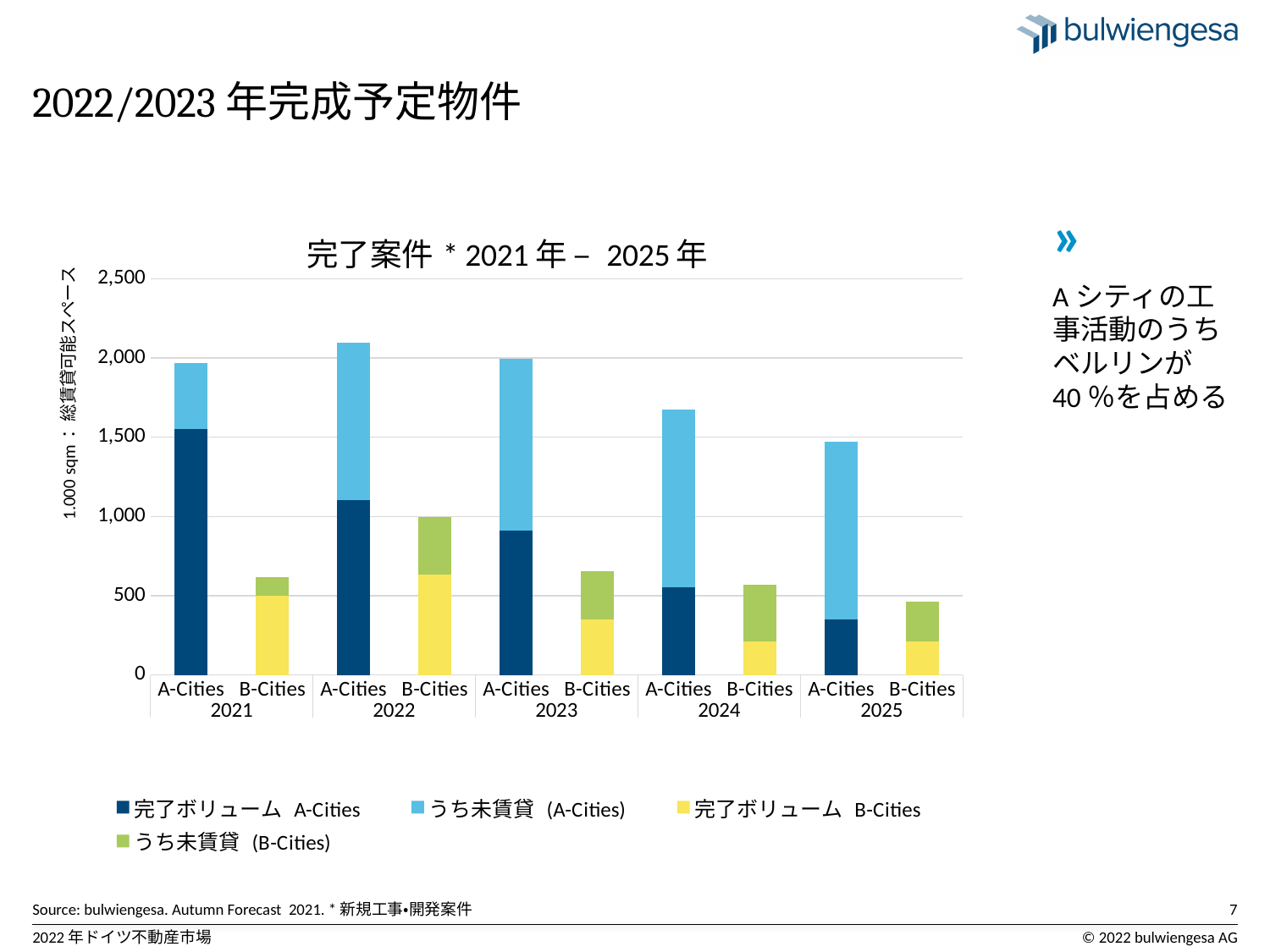
What is the title of the chart? 完了案件 * 2021 年 – 2025 年 Do the total values for A-Cities rise or fall from 2022 to 2025? fall Is the total value for B-Cities in 2025 greater or less than 500? less Which has the larger total value: A-Cities in 2023 or A-Cities in 2024? A-Cities in 2023 Which bar has the lowest total value? B-Cities 2025 What kind of chart is shown on the slide? bar chart Which bar has the highest total value? A-Cities 2022 How many series does the legend list? 4 Is the total value for B-Cities in 2021 greater or less than 500? greater Is the total value for A-Cities in 2022 greater or less than 2,000? greater How many bars are plotted in the chart? 10